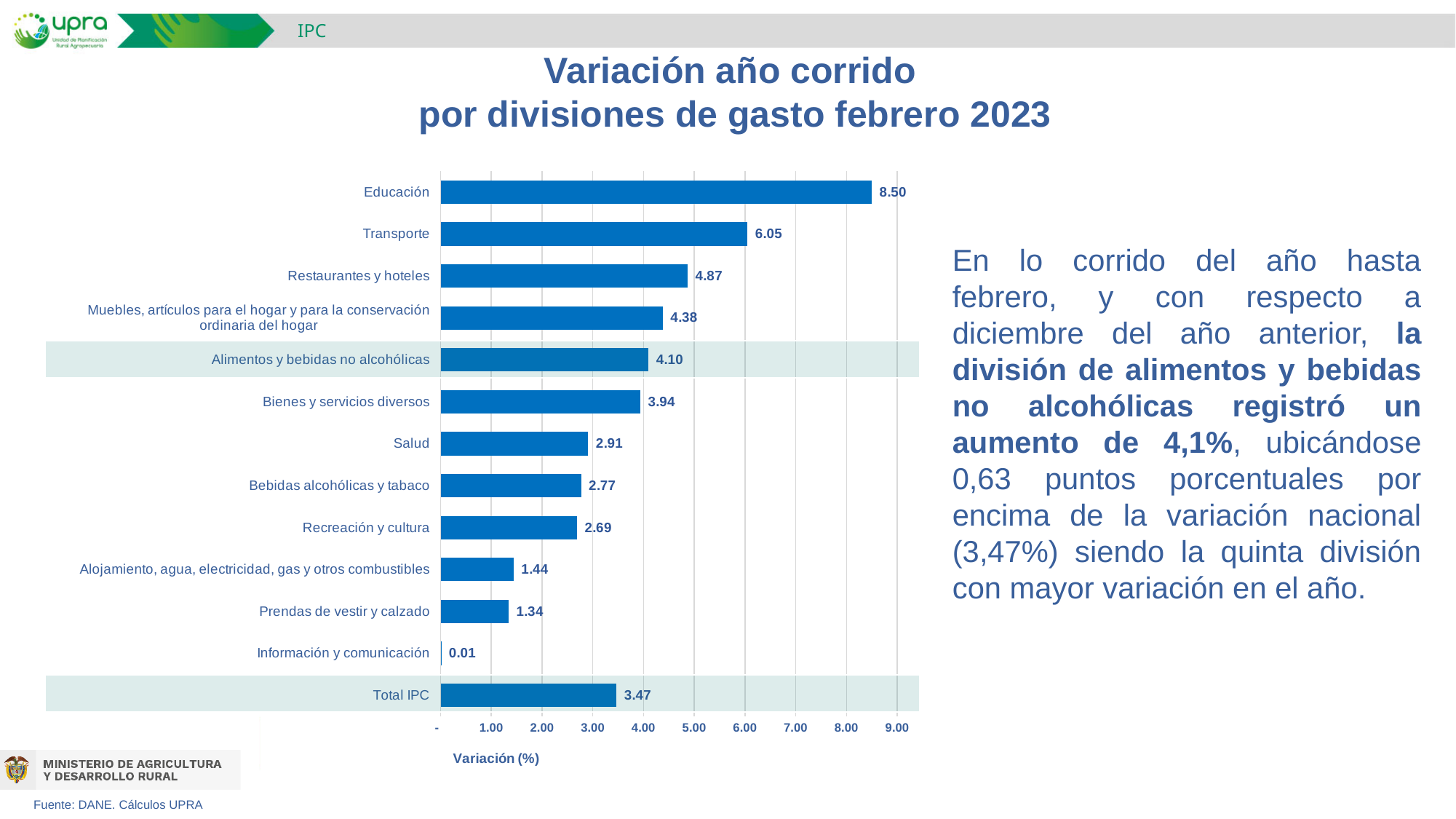
Which category has the highest value? Educación What is the value for Alimentos y bebidas no alcohólicas? 4.10 What kind of chart is shown on the slide? bar chart What is the value for Total IPC? 3.47 What is the difference between Alimentos y bebidas no alcohólicas and Total IPC? 0.63 How many categories are shown in the chart? 13 Which category has the lowest value? Información y comunicación Is the value for Restaurantes y hoteles greater or less than 4.00? greater What is the difference between the values for Educación and Transporte? 2.45 Which is larger, the value for Salud or the value for Bebidas alcohólicas y tabaco? Salud What is the label of the horizontal axis? Variación (%) What is the value for Educación? 8.50